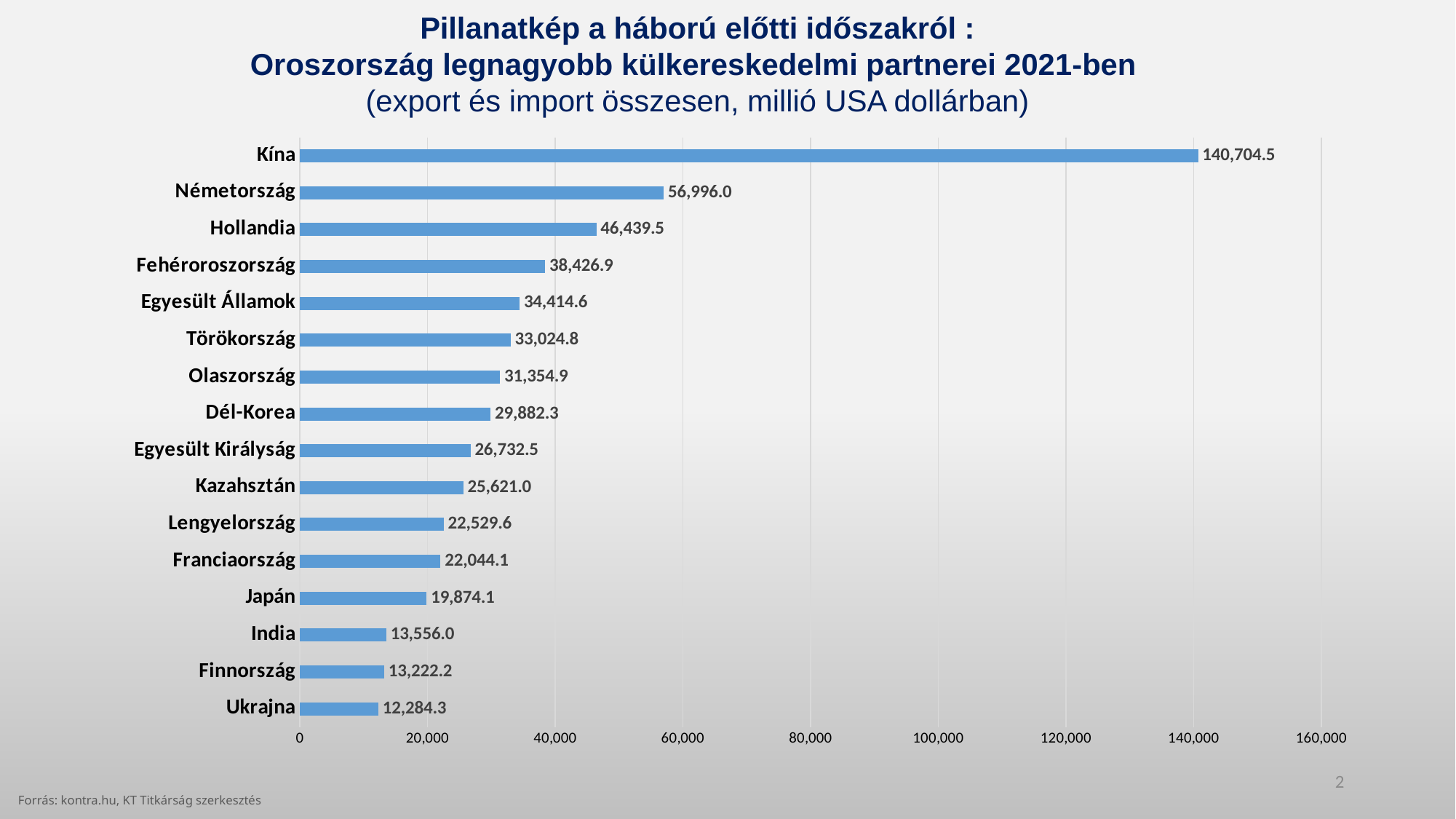
What is the difference between the values for Kína and Németország? 83,708.5 Which country has the highest value? Kína Is the value for Németország greater or less than 40,000? greater What is the source cited at the bottom of the slide? kontra.hu, KT Titkárság szerkesztés What is the value for Japán? 19,874.1 What is the value for Kína? 140,704.5 What is the value for Hollandia? 46,439.5 What kind of chart is shown on the slide? bar chart Which has a larger value, Törökország or Olaszország? Törökország What is the difference between the values for Hollandia and Fehéroroszország? 8,012.6 How many countries are shown in the chart? 16 Which country has the lowest value? Ukrajna